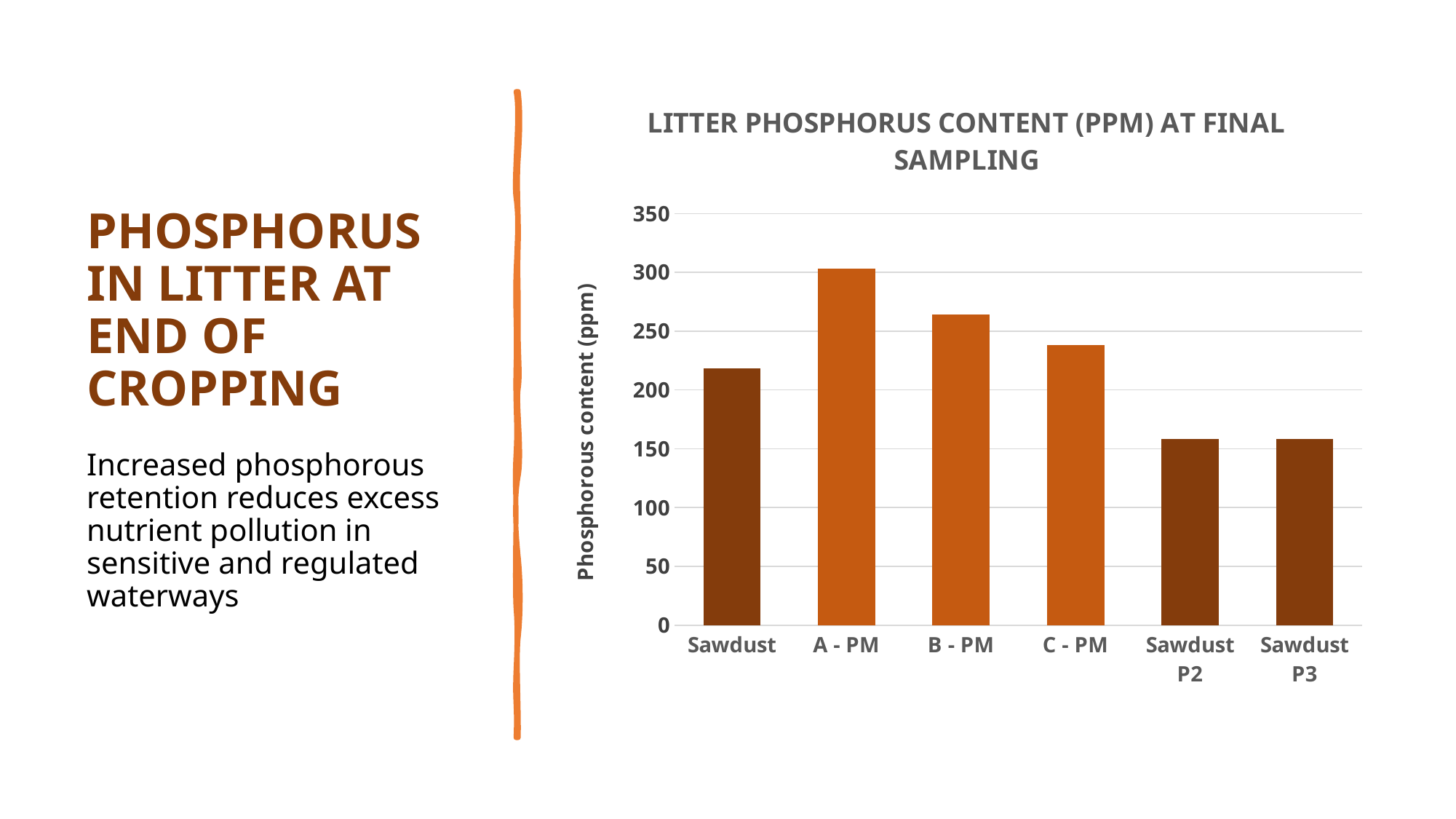
How many categories are shown on the x axis of the chart? 6 Which has a higher phosphorus content, Sawdust or Sawdust P3? Sawdust What is the label on the y axis of the chart? Phosphorous content (ppm) Is the value for A - PM greater or less than 350? less Which category has the highest litter phosphorus content? A - PM Is the value for C - PM greater or less than 250? less Do the values rise or fall from A - PM to C - PM? fall Is the value for Sawdust P2 greater or less than 200? less What kind of chart is shown on the slide? Bar chart Which has a higher phosphorus content, B - PM or C - PM? B - PM